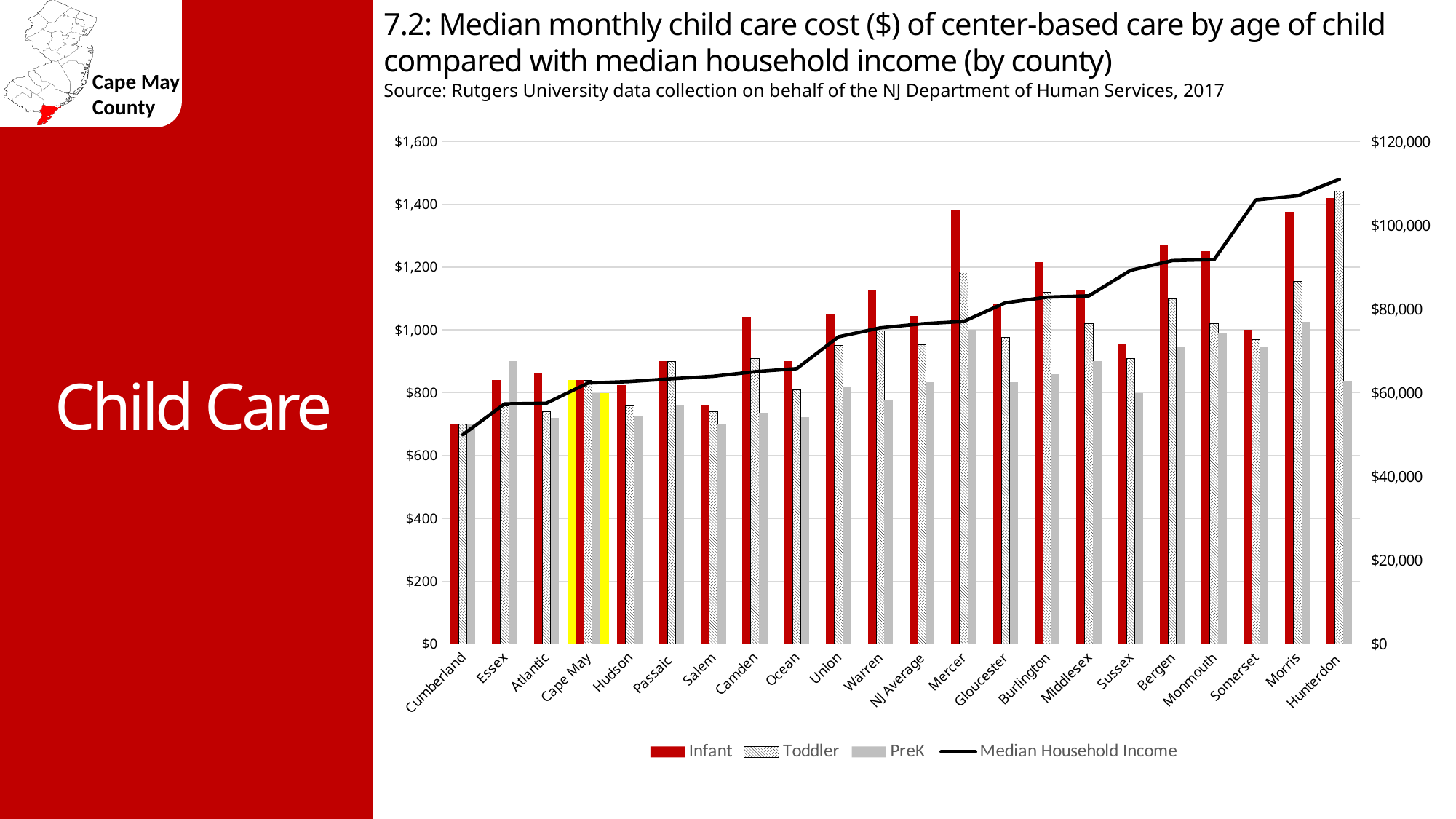
For Essex, which is larger, the Infant value or the PreK value? PreK Is the Infant value for Cape May greater or less than $800? greater Is the Infant value for Mercer greater or less than $1,200? greater Which category has the highest Toddler value? Hunterdon How many series does the legend list? 4 Is the Median Household Income for Hunterdon greater or less than $100,000? greater Which category has the lowest Infant value? Cumberland Does the Median Household Income line generally rise or fall from left to right across the x axis? rise What kind of chart is shown on the slide? Bar chart with a line series How many categories are shown along the x axis? 22 Which county's bars are highlighted in yellow on the chart? Cape May